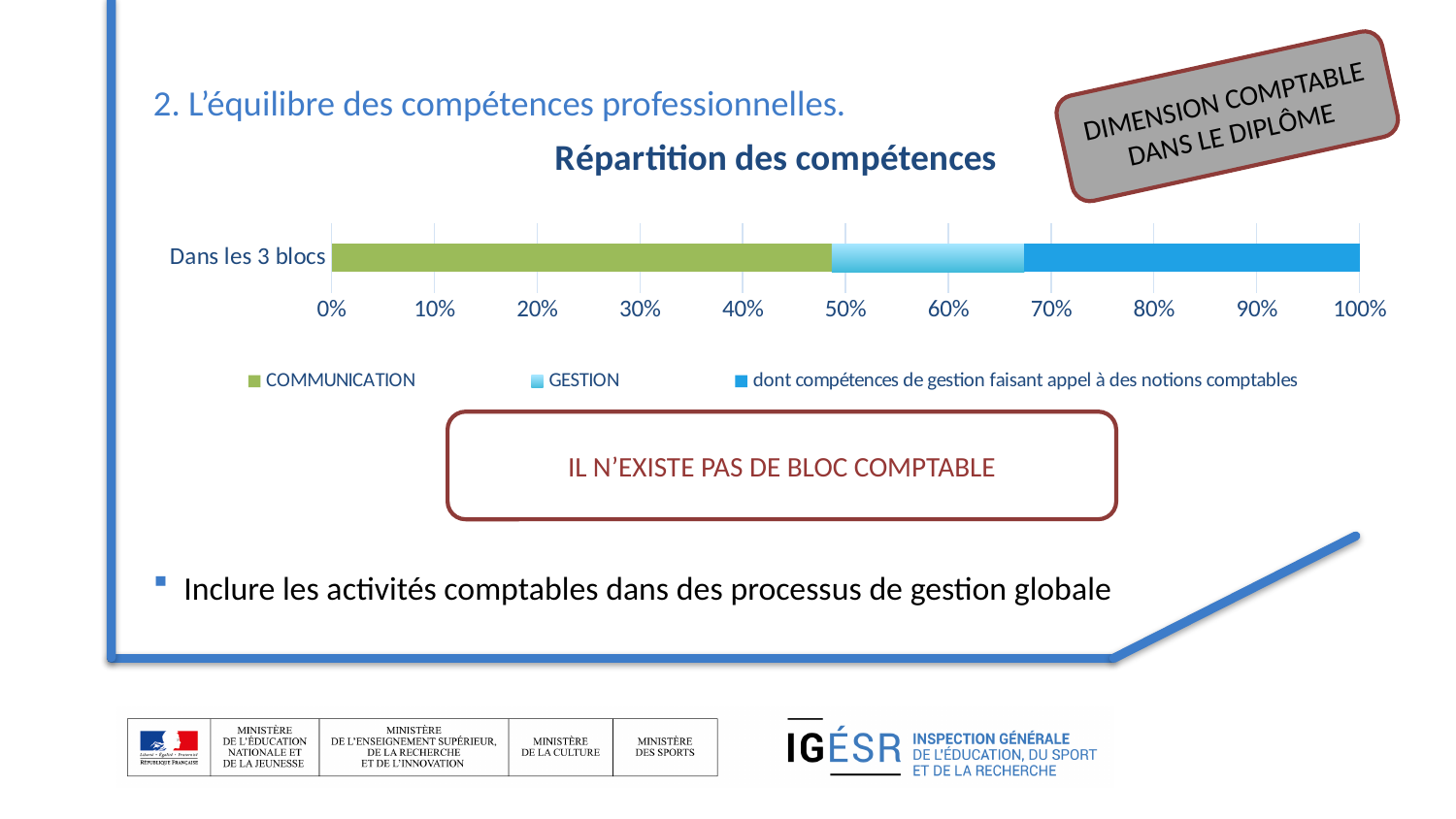
What is the label of the single category plotted on the chart? Dans les 3 blocs How many categories are plotted on the chart's vertical axis? 1 Which series occupies the smallest share of the bar for "Dans les 3 blocs"? GESTION Is the GESTION share of the bar greater or less than 30%? less Is the COMMUNICATION share of the bar greater or less than 40%? greater Is the share for "dont compétences de gestion faisant appel à des notions comptables" greater or less than 30%? greater What is the highest value shown on the chart's horizontal axis? 100% Which series occupies the largest share of the bar for "Dans les 3 blocs"? COMMUNICATION What is the title of the chart? Répartition des compétences How many series does the chart legend list? 3 What kind of chart is shown under the title "Répartition des compétences"? Stacked bar chart Which is larger in the bar: the COMMUNICATION segment or the GESTION segment? COMMUNICATION